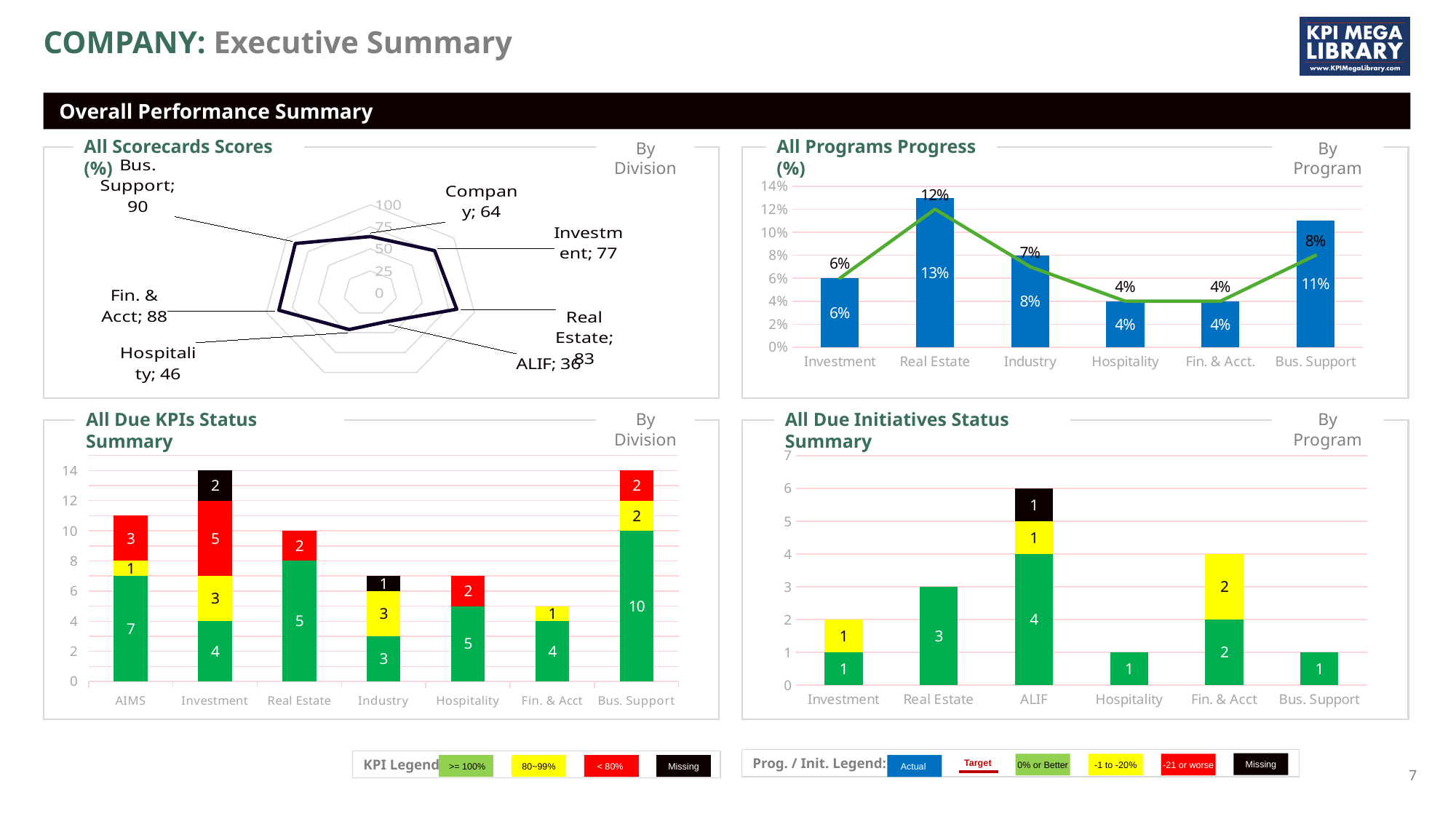
In the All Scorecards Scores (%) chart, what is the score for Bus. Support? 90 What type of chart is the All Scorecards Scores (%) chart? Radar chart In the All Programs Progress (%) chart, how many programs are shown on the x axis? 6 In the All Due KPIs Status Summary chart, what is the green (>= 100%) value for Bus. Support? 10 In the All Due Initiatives Status Summary chart, what is the total of the ALIF stacked bar? 6 In the All Scorecards Scores (%) chart, which division has the lowest score? ALIF In the All Scorecards Scores (%) chart, what is the difference between the Fin. & Acct score and the Hospitality score? 42 In the All Programs Progress (%) chart, which program has the highest Actual bar? Real Estate In the All Due KPIs Status Summary chart, which division has the lowest total bar? Fin. & Acct In the All Programs Progress (%) chart, what is the Actual value for Real Estate? 13% In the All Programs Progress (%) chart, what is the Target value for Bus. Support? 8% In the All Due KPIs Status Summary chart, what is the total height of the Investment stacked bar? 14